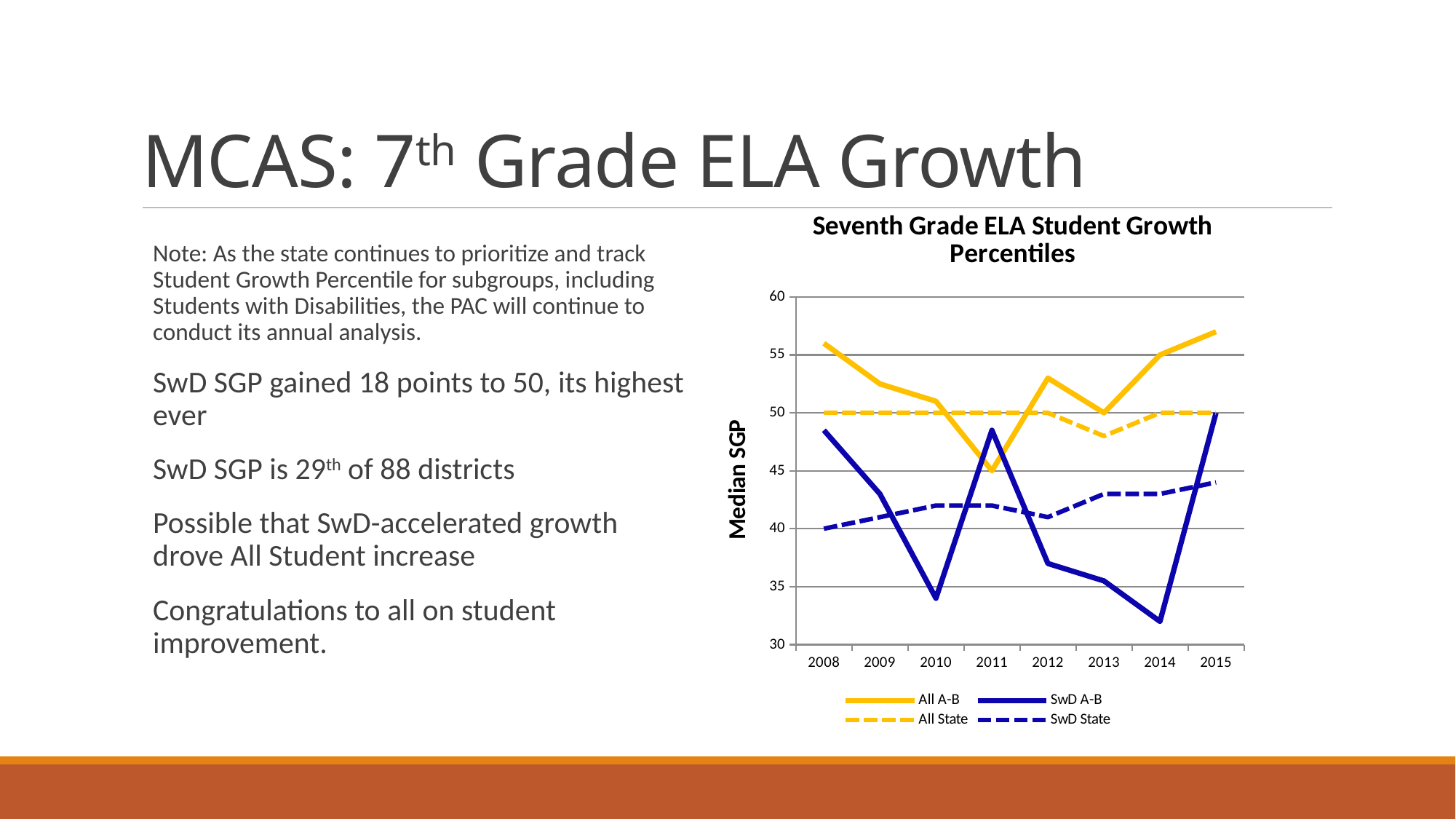
Does the SwD A-B series rise or fall from 2014 to 2015? Rise How many years are shown on the x axis of the chart? 8 In which year is the SwD A-B series at its lowest? 2014 What is the SwD A-B value in 2015? 50 In 2012, which is larger: All A-B or SwD A-B? All A-B In which year is the All A-B series at its highest? 2015 What type of chart is shown on the slide? Line chart Is the SwD A-B value for 2014 greater or less than 35? less Is the All A-B value for 2015 greater or less than 55? greater What is the All A-B value in 2011? 45 What is the label on the y axis of the chart? Median SGP How many series does the legend of the chart list? 4